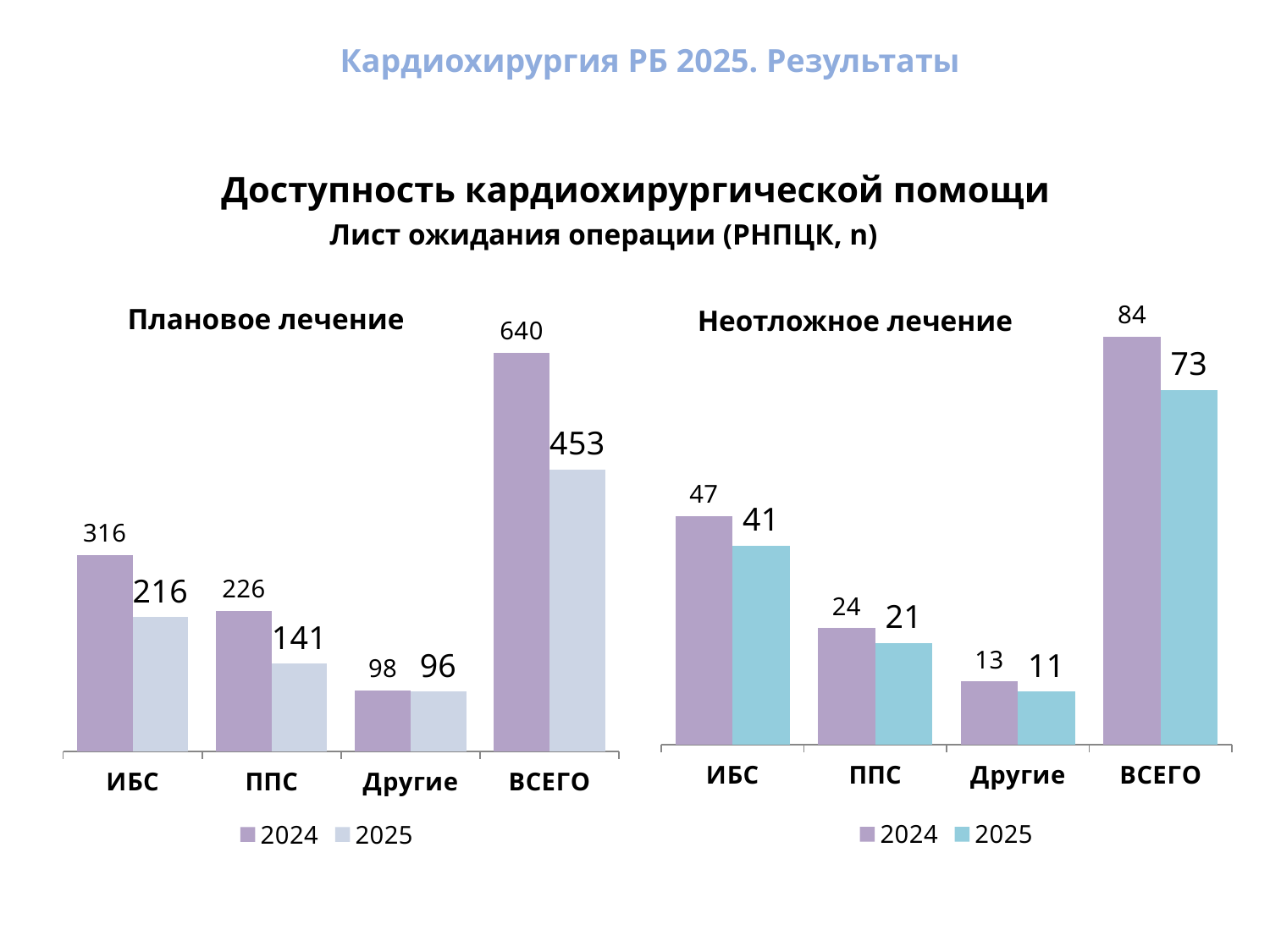
In the 'Неотложное лечение' chart, what is the value for Другие in 2024? 13 In the 'Плановое лечение' chart, what is the value for ППС in 2025? 141 In the 'Неотложное лечение' chart, which category has the highest 2024 value? ВСЕГО In the 'Неотложное лечение' chart, what is the difference between the 2024 and 2025 values for ИБС? 6 In the 'Плановое лечение' chart, which category has the lowest 2025 value? Другие In the 'Неотложное лечение' chart, what is the value for ВСЕГО in 2025? 73 How many categories are shown on the x axis of the 'Неотложное лечение' chart? 4 In the 'Плановое лечение' chart, which is larger for ППС: the 2024 value or the 2025 value? 2024 What type of chart is the 'Неотложное лечение' chart? Bar chart In the 'Плановое лечение' chart, what is the value for ИБС in 2024? 316 How many series does the legend of the 'Плановое лечение' chart list? 2 In the 'Плановое лечение' chart, what is the difference between the 2024 and 2025 values for ВСЕГО? 187